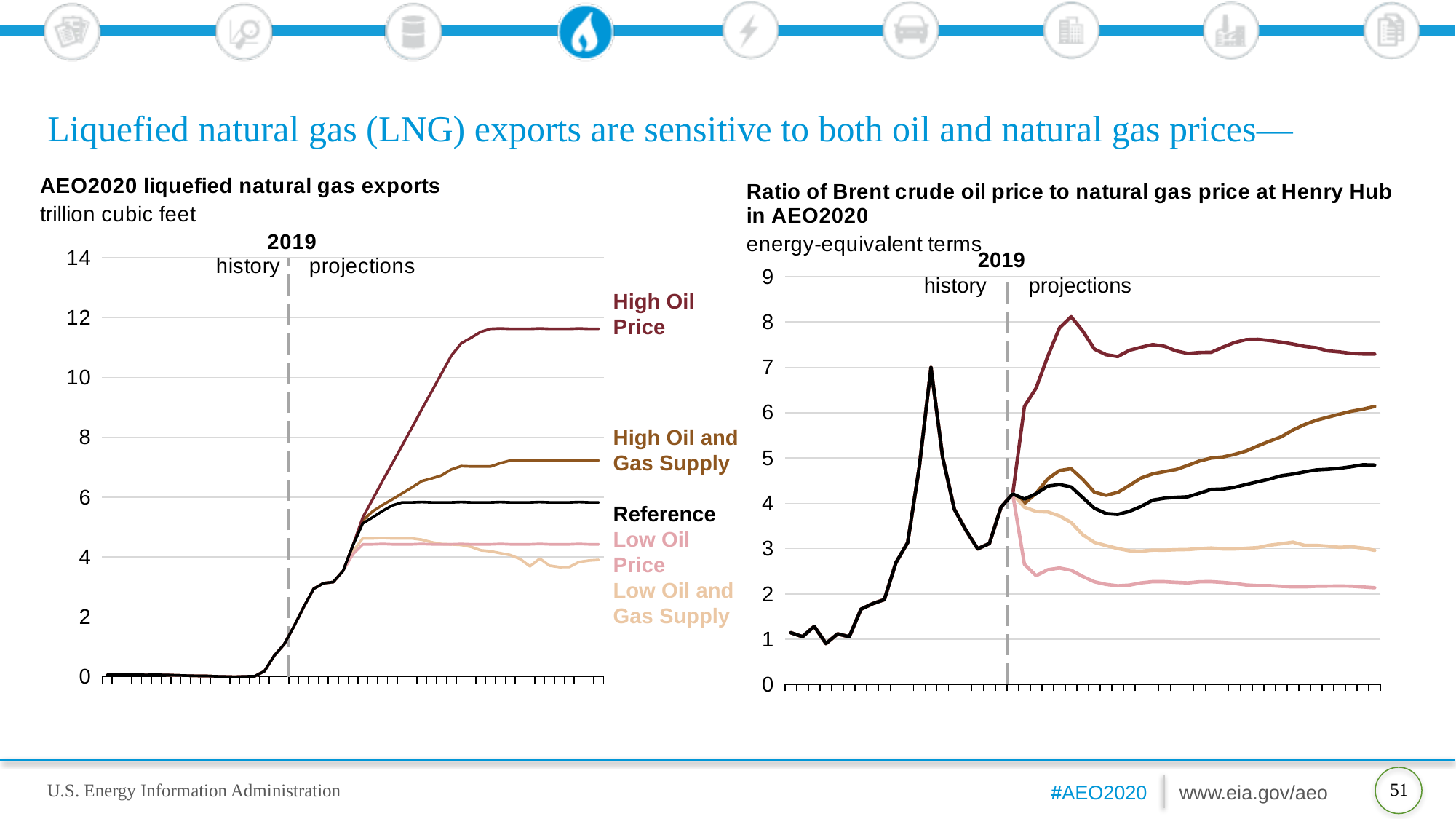
In the left chart, 'AEO2020 liquefied natural gas exports', is the Low Oil and Gas Supply value at the end of the projection period greater or less than 6? less In the right chart, 'Ratio of Brent crude oil price to natural gas price at Henry Hub in AEO2020', is the High Oil Price value at the end of the projection period greater or less than 6? greater What kind of chart is the left chart, 'AEO2020 liquefied natural gas exports'? line chart In the right chart, 'Ratio of Brent crude oil price to natural gas price at Henry Hub in AEO2020', which series is lowest at the end of the projection period? Low Oil Price What kind of chart is the right chart, 'Ratio of Brent crude oil price to natural gas price at Henry Hub in AEO2020'? line chart In the right chart, 'Ratio of Brent crude oil price to natural gas price at Henry Hub in AEO2020', does the High Oil and Gas Supply series rise or fall over the projection period? rise In the left chart, 'AEO2020 liquefied natural gas exports', what unit is shown under the title? trillion cubic feet In the left chart, 'AEO2020 liquefied natural gas exports', which series is lowest at the end of the projection period? Low Oil and Gas Supply In the left chart, 'AEO2020 liquefied natural gas exports', which series is highest at the end of the projection period? High Oil Price In the left chart, 'AEO2020 liquefied natural gas exports', is the High Oil Price value at the end of the projection period greater or less than 10? greater How many series are shown in the left chart, 'AEO2020 liquefied natural gas exports'? 5